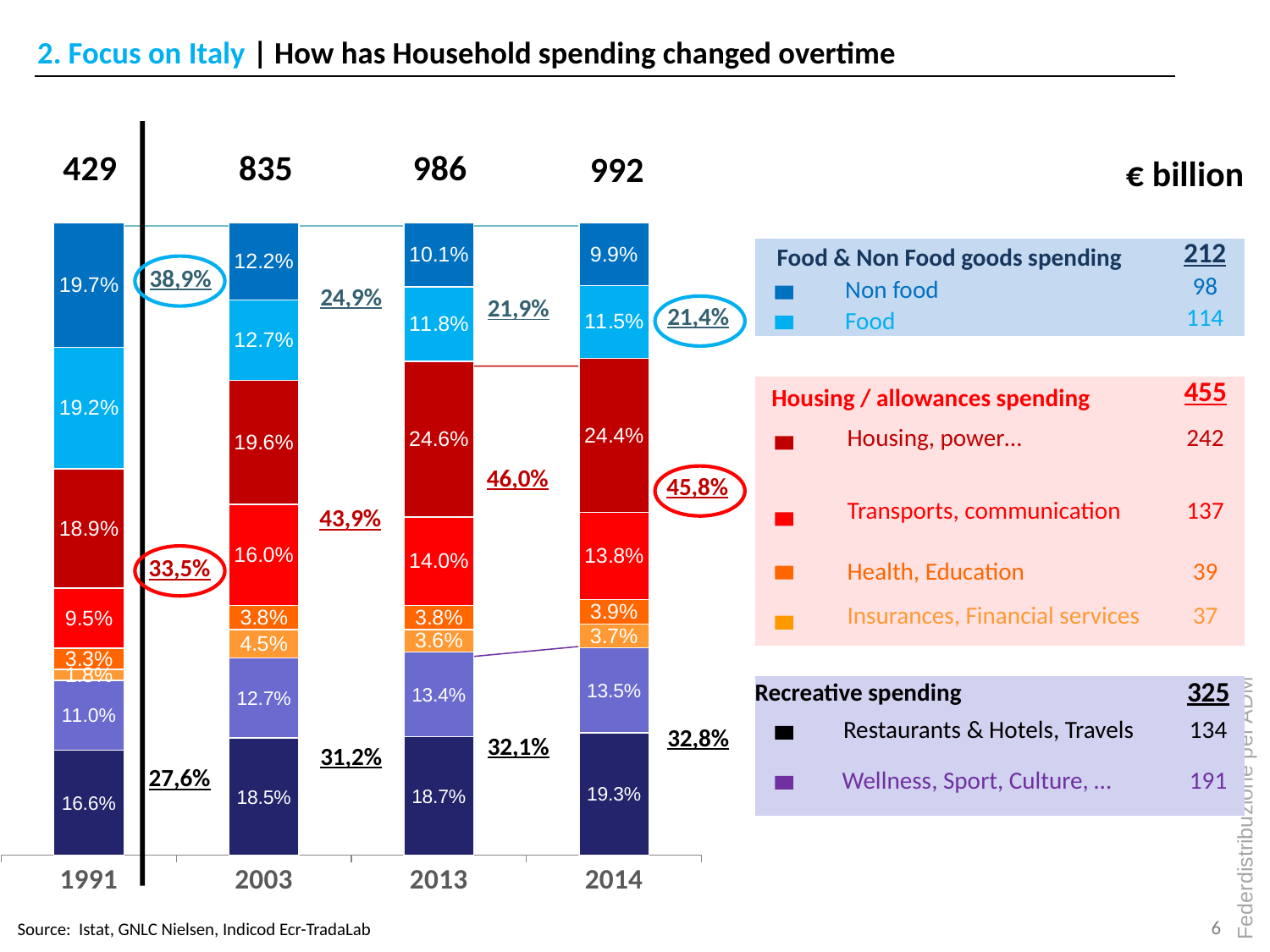
What percentage share does the Housing, power... segment have in the 2013 bar? 24.6% How many years (bars) are shown on the x axis of the chart? 4 What is the difference between the total spending in 2013 and in 1991 (€ billion)? 557 What is the total household spending in € billion shown above the 2014 bar? 992 Which year has the lowest Housing / allowances spending share? 1991 How many spending categories does the legend list in total? 8 What is the Food & Non Food goods spending share (circled) for 1991? 38,9% What type of chart is shown on the slide? Stacked bar chart Which is larger in 2003: the Food share or the Non food share? Food (12.7%) Which year has the highest total household spending shown above the bars? 2014 According to the legend, what is the total Housing / allowances spending in € billion? 455 How does the Recreative spending share change from 1991 to 2014? It rises (27,6% to 32,8%)